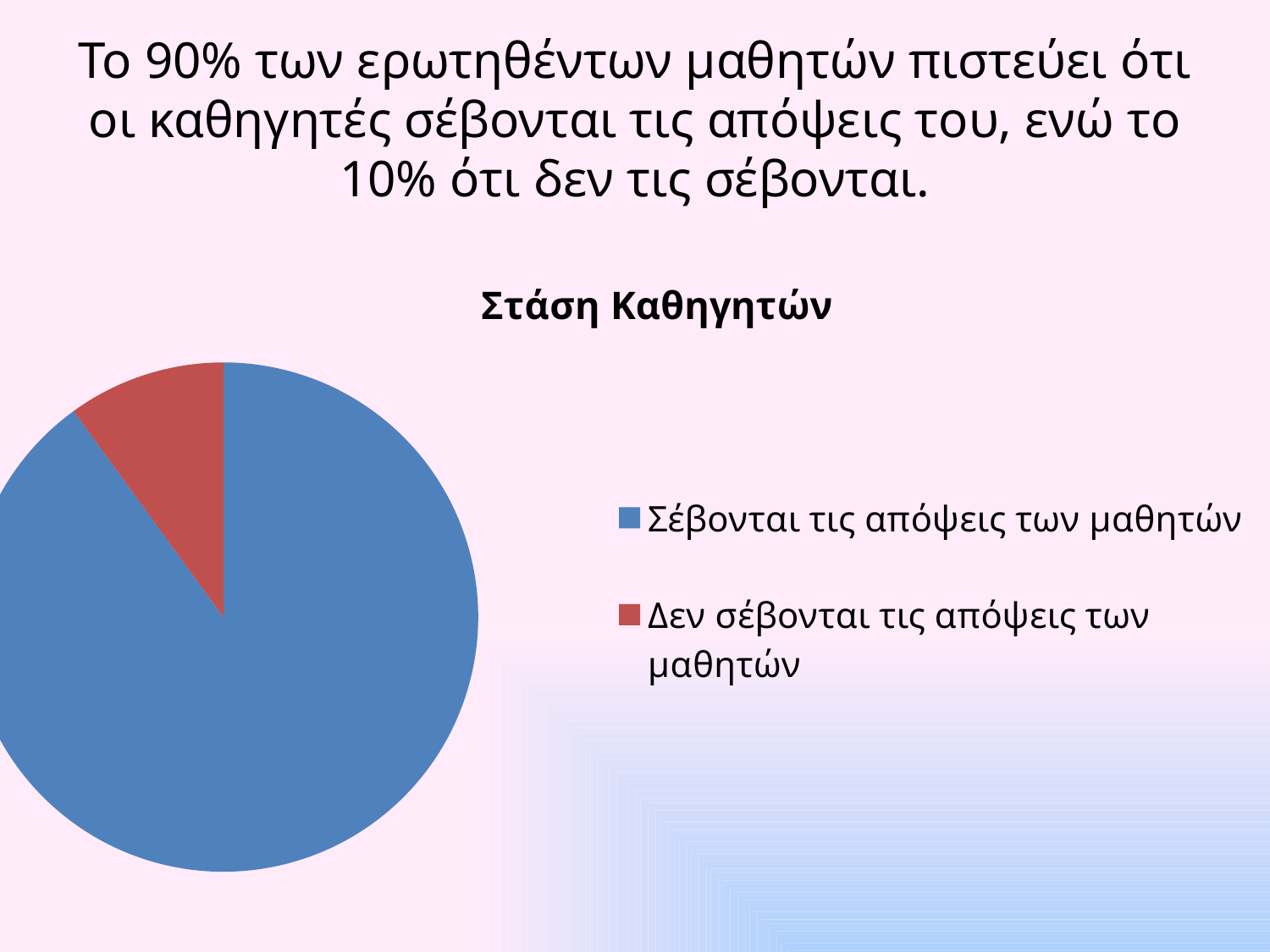
What colour is the slice for 'Δεν σέβονται τις απόψεις των μαθητών'? red Which category has the largest slice of the pie? Σέβονται τις απόψεις των μαθητών How many slices does the pie chart have? 2 What is the title of the chart? Στάση Καθηγητών What kind of chart is shown on the slide? pie chart Which category has the smallest slice of the pie? Δεν σέβονται τις απόψεις των μαθητών How many entries does the legend list? 2 What share of the pie does 'Δεν σέβονται τις απόψεις των μαθητών' represent? 10% What share of the pie does 'Σέβονται τις απόψεις των μαθητών' represent? 90% Which slice is larger: 'Σέβονται τις απόψεις των μαθητών' or 'Δεν σέβονται τις απόψεις των μαθητών'? Σέβονται τις απόψεις των μαθητών